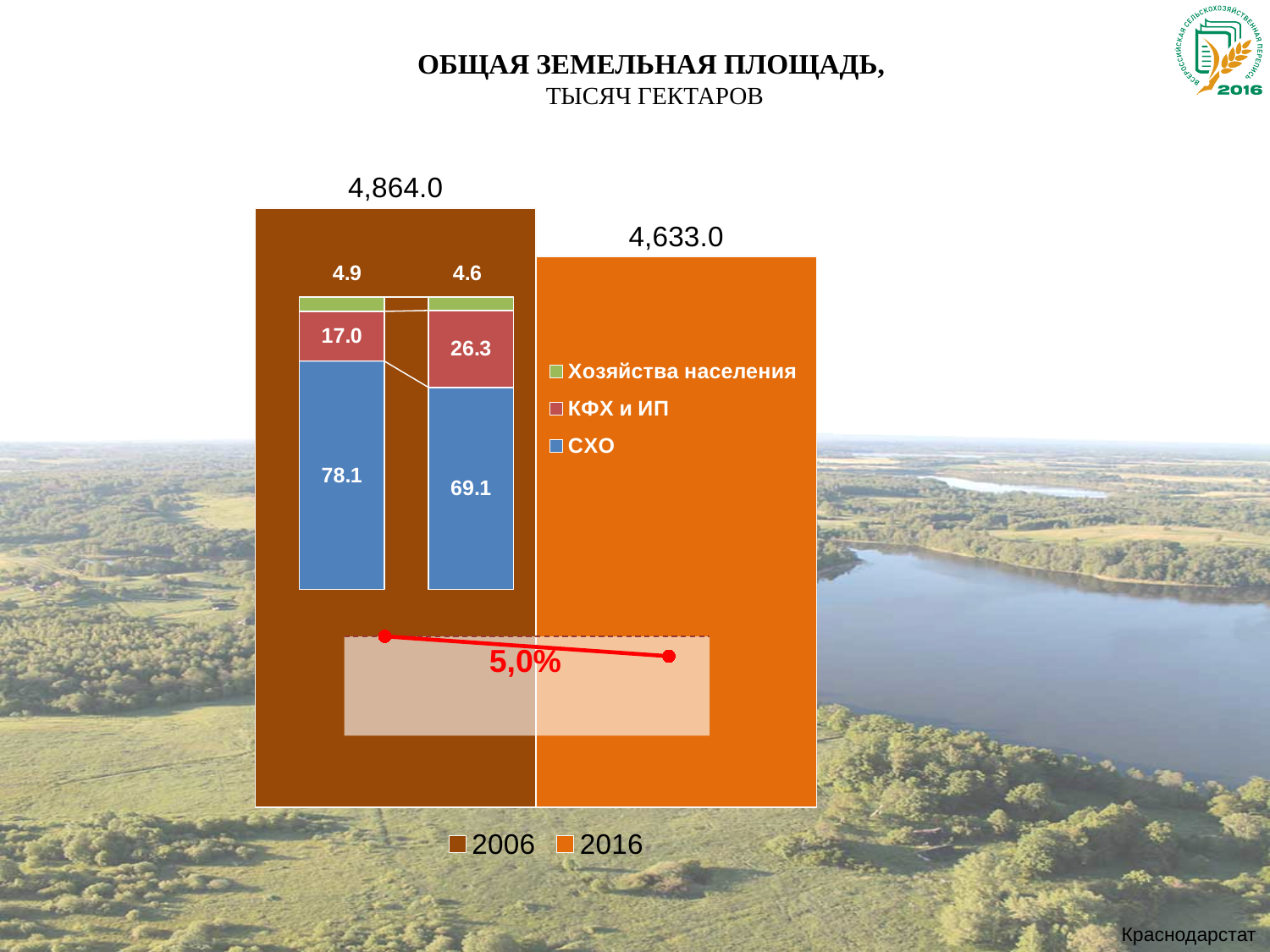
In the inner stacked bar chart, what is the value for КФХ и ИП in 2016? 26.3 In the large bar chart of total land area, how many series does the legend list? 2 In the inner stacked bar chart, which segment is the largest in 2016? СХО In the inner stacked bar chart, what is the value for СХО in 2006? 78.1 In the large bar chart of total land area, what is the difference between the 2006 and 2016 values? 231.0 In the large bar chart of total land area, what is the value for 2006? 4,864.0 In the inner stacked bar chart, what is the difference between the КФХ и ИП values for 2016 and 2006? 9.3 In the large bar chart of total land area, what is the value for 2016? 4,633.0 In the inner stacked bar chart, what is the value for Хозяйства населения in 2016? 4.6 In the large bar chart of total land area, which year has the larger value, 2006 or 2016? 2006 In the inner stacked bar chart, how many series does the legend list? 3 What percentage change is shown by the red line between 2006 and 2016? 5,0%